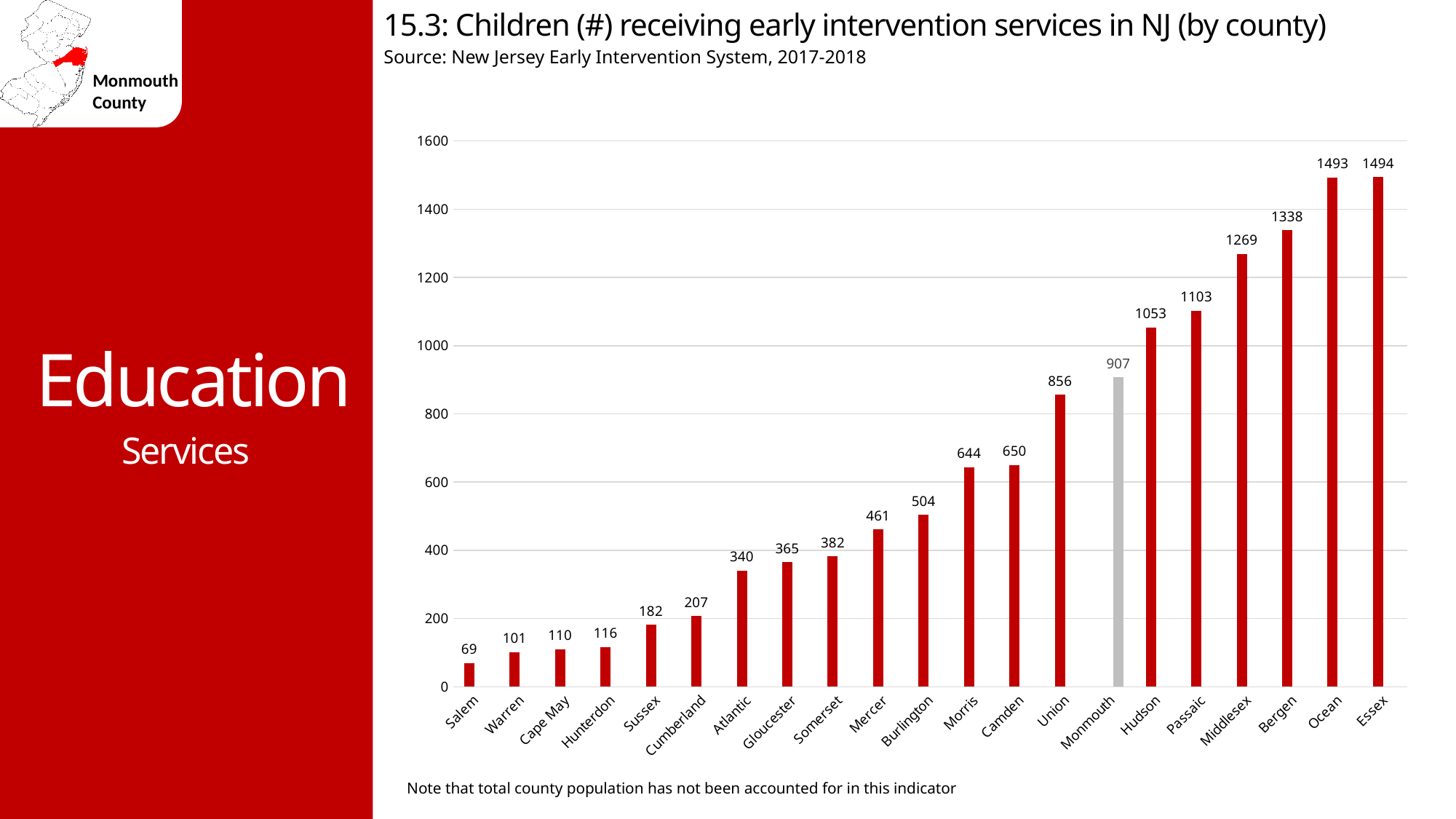
Which county has a higher value, Union or Burlington? Union What is the value shown for Cumberland County? 207 What is the difference between the values for Camden and Morris? 6 What is the value shown for Bergen County? 1338 How many children received early intervention services in Monmouth County? 907 Which county has a higher value, Middlesex or Passaic? Middlesex Which county's bar is shown in grey rather than red? Monmouth Is the value for Mercer greater or less than 400? greater Which county has the lowest number of children receiving early intervention services? Salem What is the difference between the values for Hudson and Monmouth? 146 How many counties are shown on the chart? 21 What kind of chart is shown on the slide? Bar chart